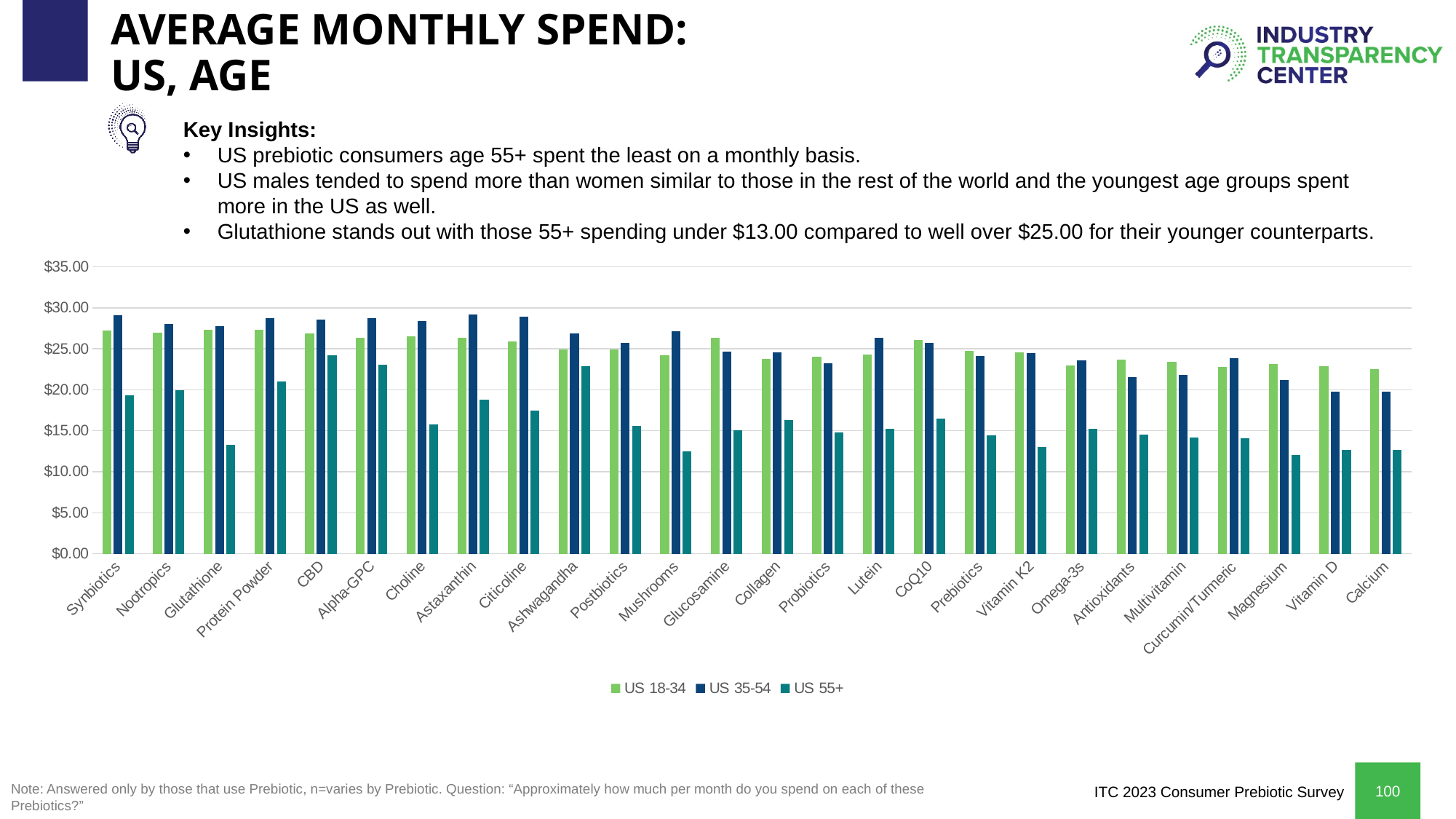
For Lutein, which is larger: the US 18-34 value or the US 35-54 value? US 35-54 Is the US 35-54 value for Synbiotics greater or less than $25.00? greater Is the US 55+ value for Vitamin D greater or less than $15.00? less Which series is shown in light green in the chart legend? US 18-34 For Glutathione, which is larger: the US 18-34 value or the US 55+ value? US 18-34 What kind of chart is shown on the slide? bar chart How many series does the chart legend list? 3 Is the US 55+ value for Glutathione greater or less than $15.00? less How many product categories are shown along the x axis of the chart? 26 Do the US 18-34 values generally rise or fall from left to right across the x axis? fall